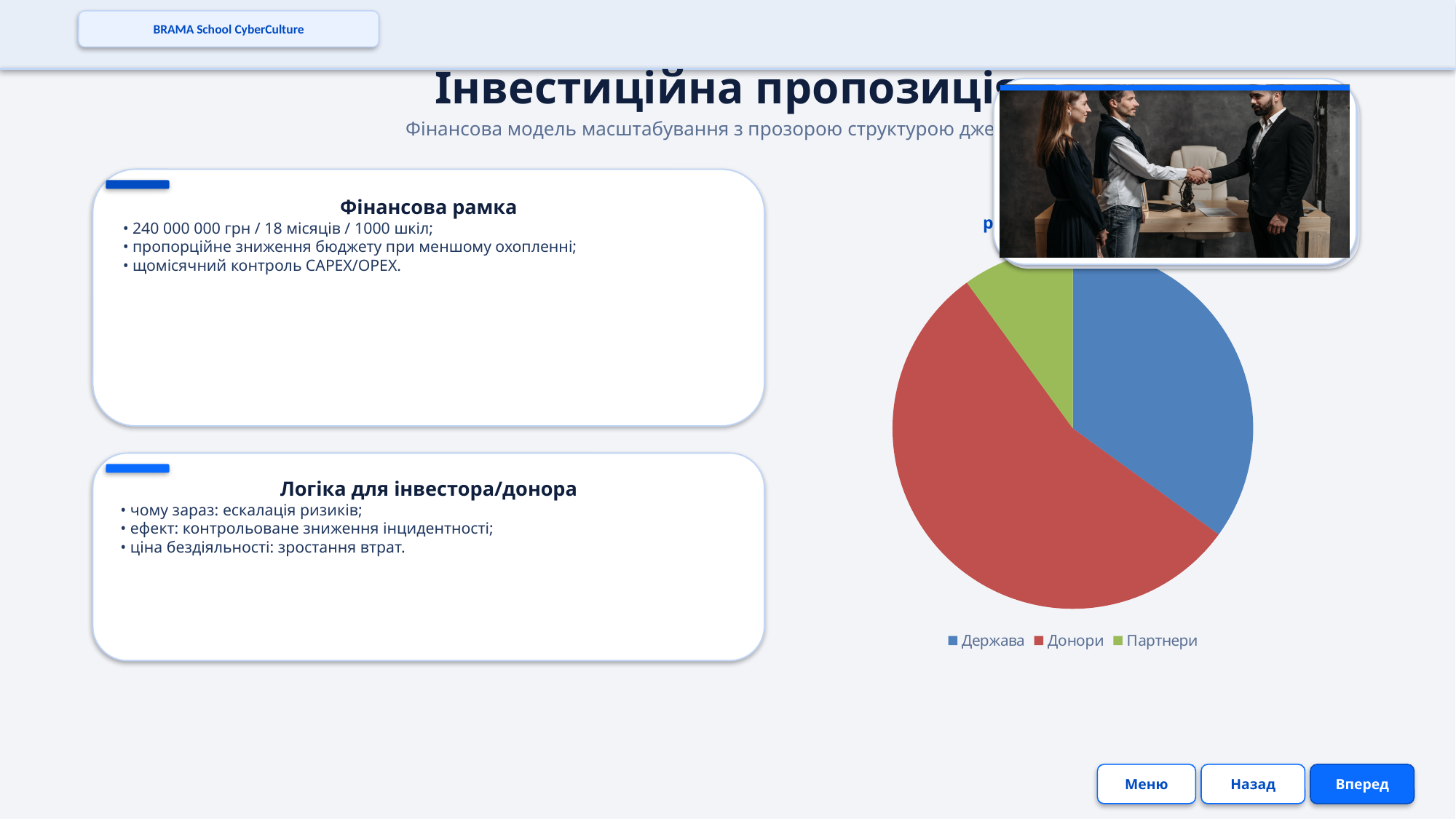
Which slice is larger in the pie chart, Держава or Партнери? Держава How many slices does the pie chart have? 3 Which slice is smaller in the pie chart, Донори or Партнери? Партнери Which category has the smallest slice in the pie chart? Партнери Which category is shown in green in the pie chart? Партнери Which slice is larger in the pie chart, Донори or Держава? Донори How many entries does the legend of the pie chart list? 3 What colour is the Держава slice in the pie chart? blue Which category has the largest slice in the pie chart? Донори What kind of chart is shown on the slide? pie chart